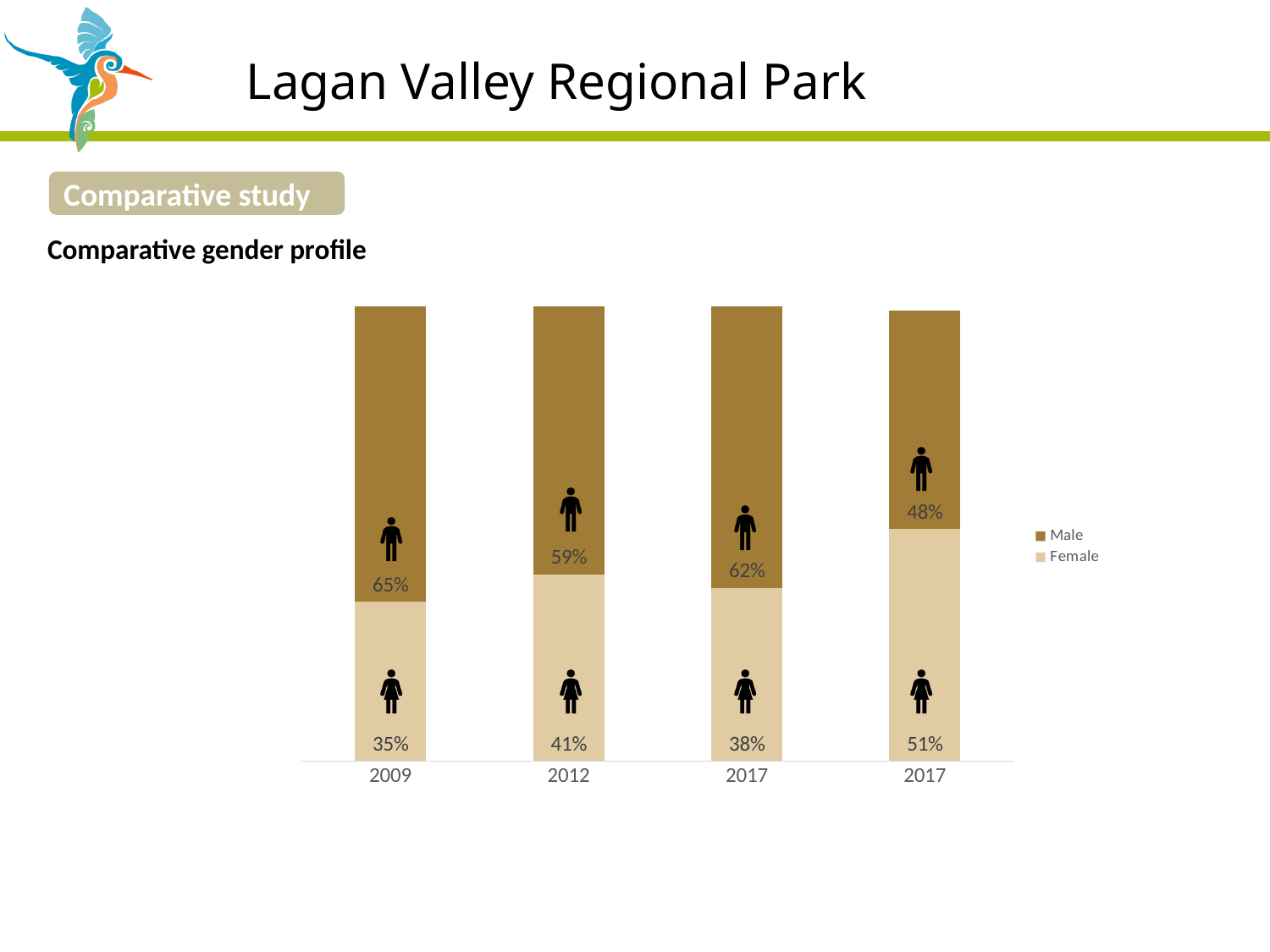
What is the Female value for 2012? 41% Which is larger, the Male value for 2009 or the Male value for 2012? 2009 What is the difference between the Male and Female values in 2009? 30 percentage points What is the Female value for the third bar from the left (the first bar labelled 2017)? 38% What is the total of the stacked bar for 2009? 100% What kind of chart is shown? Stacked bar chart Which bar has the lowest Male value? The rightmost bar (second 2017), 48% How many bars are shown on the x axis? 4 How many series does the legend list? 2 What is the Male value for the rightmost bar (the second bar labelled 2017)? 48% What is the Male value for 2009? 65% Which bar has the highest Female value? The rightmost bar (second 2017), 51%